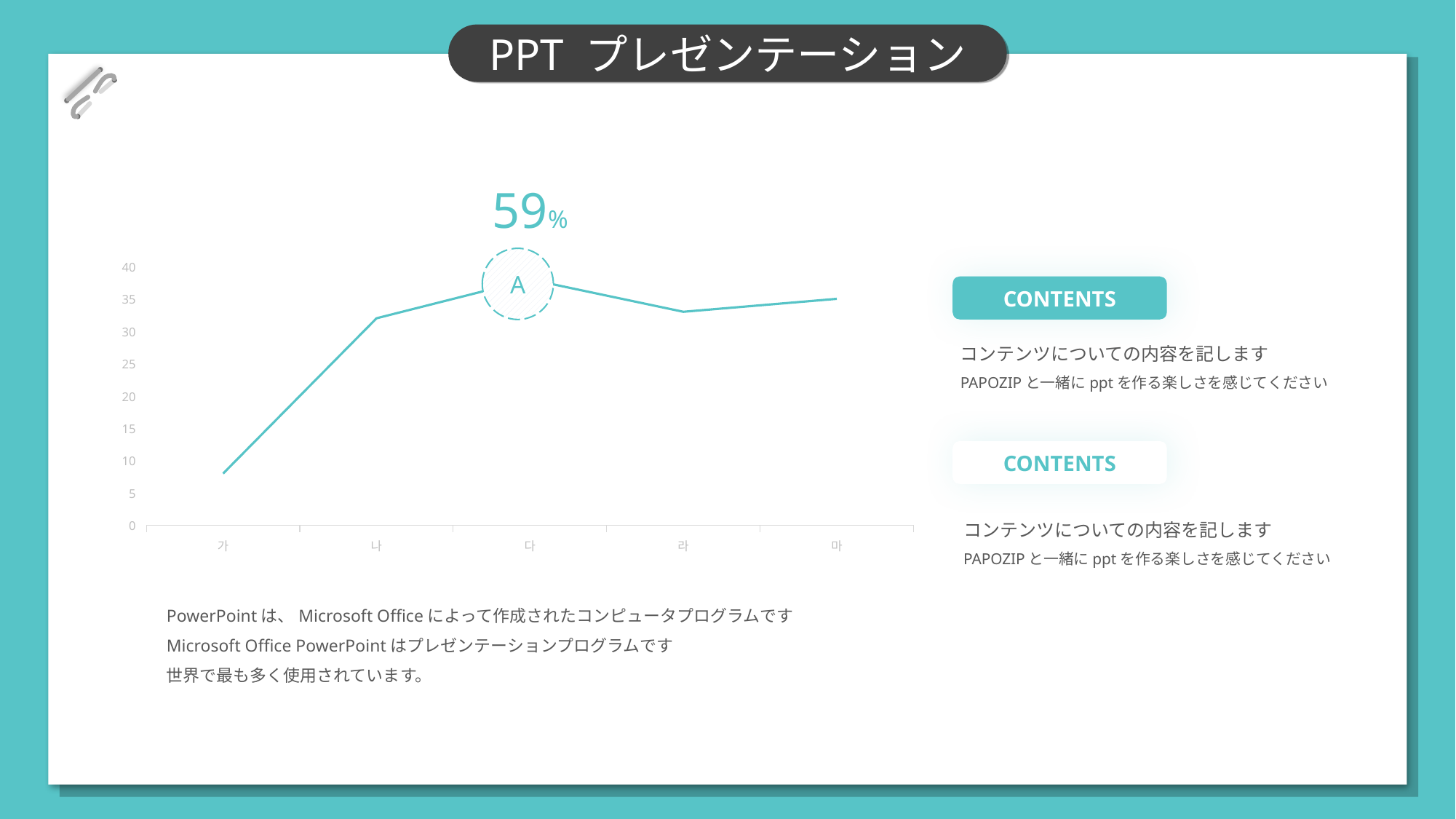
What percentage is printed in the callout above the chart's peak? 59% How many categories are shown on the x axis of the chart? 5 Which has the larger value, 가 or 나? 나 What kind of chart is shown on the slide? line chart Is the value for 나 greater or less than 30? greater Is the value for 가 greater or less than 10? less Does the line rise or fall from 가 to 나? rise Is the value for 라 greater or less than 35? less Which category has the lowest value in the chart? 가 Which category has the highest value in the chart? 다 Which has the larger value, 라 or 마? 마